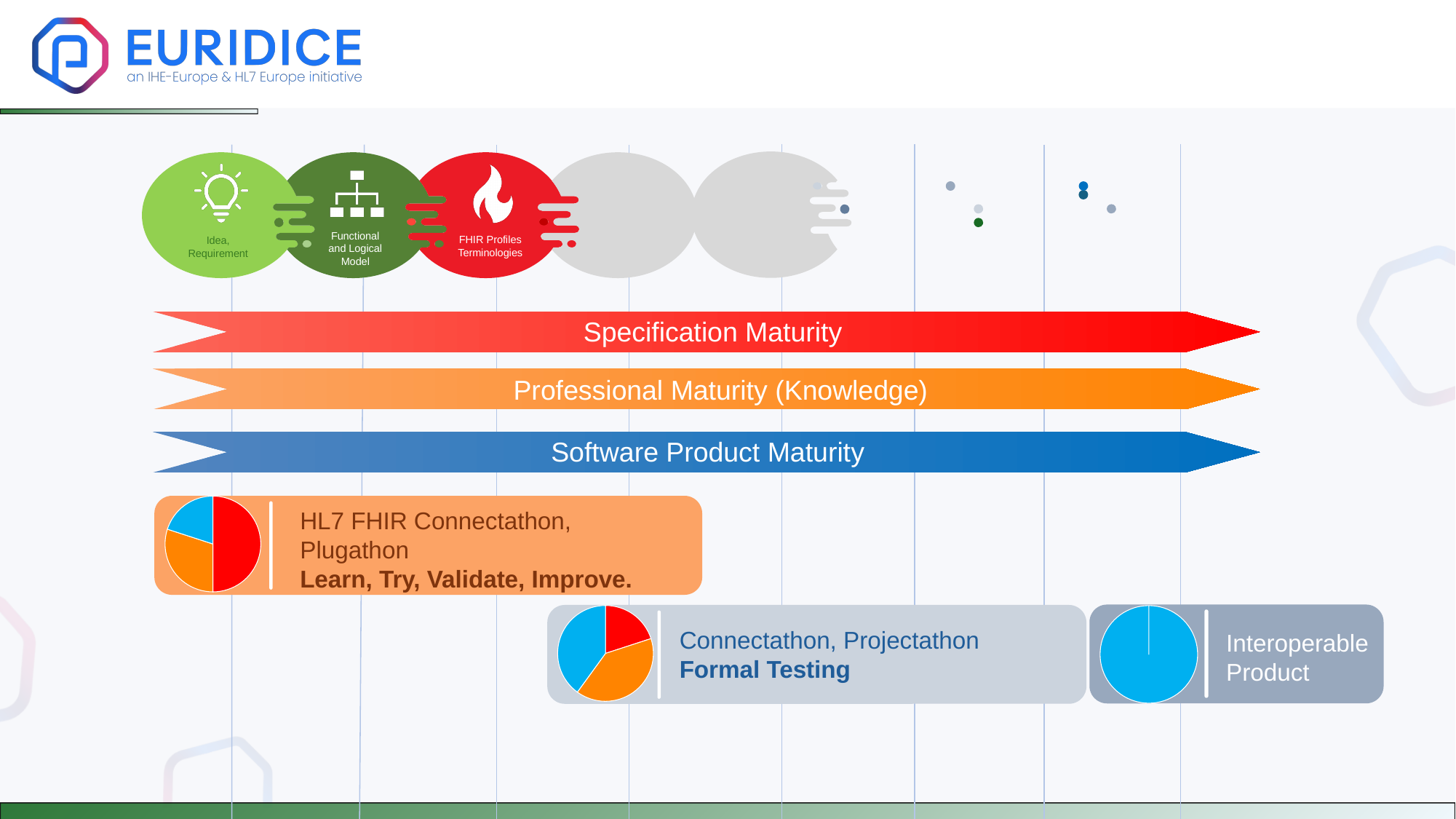
In the pie chart next to 'HL7 FHIR Connectathon, Plugathon', which colour slice is the largest? red How many slices does the pie chart next to 'Connectathon, Projectathon' have? 3 In the pie chart next to 'Connectathon, Projectathon', which colour slice is the smallest? red What kind of chart is shown next to the text 'HL7 FHIR Connectathon, Plugathon'? pie chart How many slices does the pie chart next to 'Interoperable Product' have? 1 What kind of chart is shown next to the text 'Interoperable Product'? pie chart What colour is the single slice of the pie chart next to 'Interoperable Product'? blue What kind of chart is shown next to the text 'Connectathon, Projectathon'? pie chart How many slices does the pie chart next to 'HL7 FHIR Connectathon, Plugathon' have? 3 In the pie chart next to 'Connectathon, Projectathon', is the blue slice larger or smaller than the red slice? larger How many pie charts are shown on the slide? 3